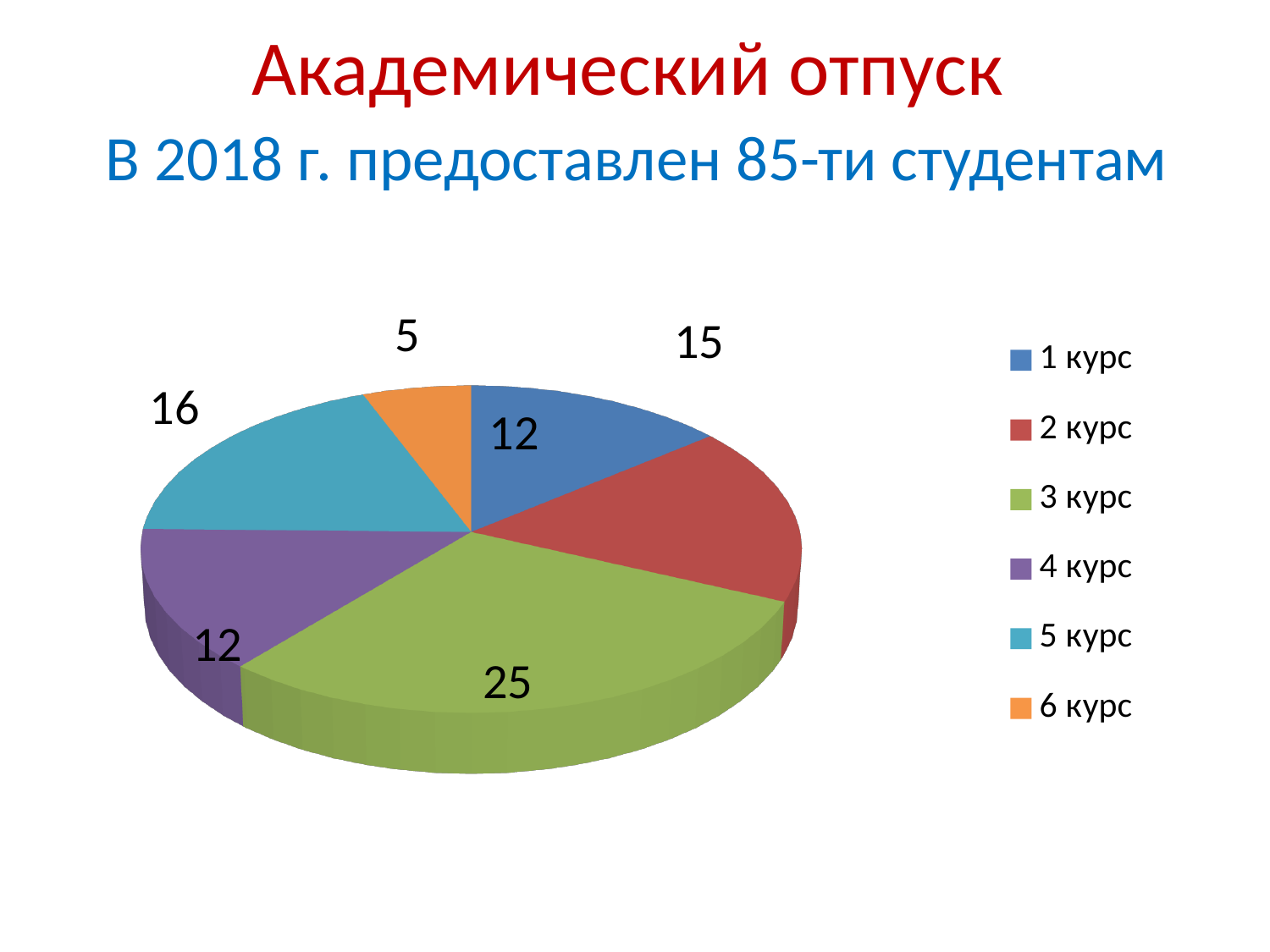
What is the value for 2 курс in the pie chart? 15 What is the difference between the values for 3 курс and 6 курс? 20 What is the value for 5 курс in the pie chart? 16 What type of chart is shown on the slide? pie chart What is the value for 6 курс in the pie chart? 5 Which course has the smallest slice of the pie chart? 6 курс What is the total number of students represented in the pie chart? 85 Which course has the largest slice of the pie chart? 3 курс What colour is the slice for 3 курс in the pie chart? green Which is larger, the value for 5 курс or the value for 2 курс? 5 курс How many categories (courses) does the pie chart show? 6 What is the value for 3 курс in the pie chart? 25